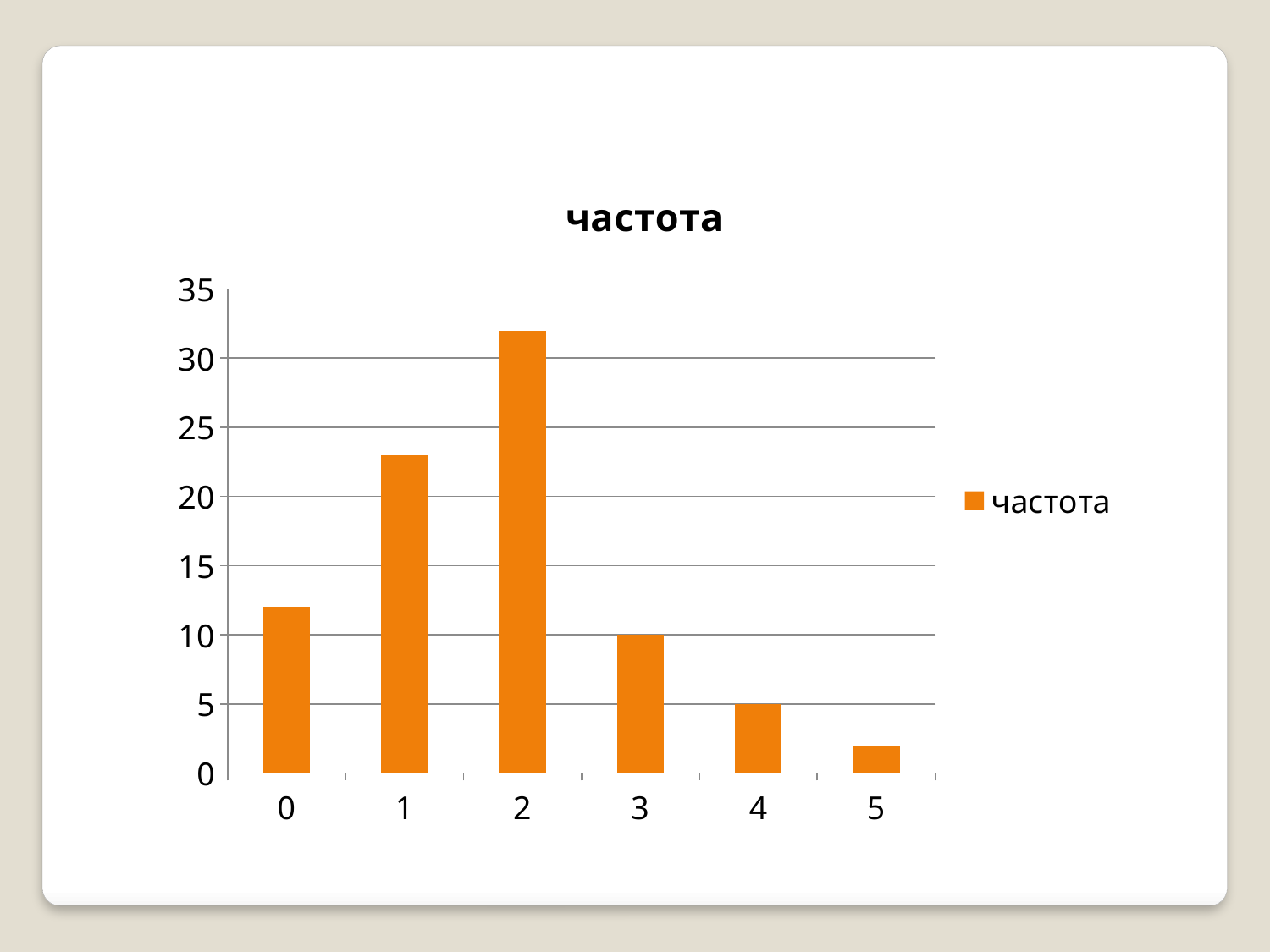
Is the value for category 1 greater or less than 25? less How many series does the legend list? 1 Is the value for category 2 greater or less than 30? greater What is the value for category 4? 5 Which is larger, the value for category 0 or the value for category 3? category 0 What is the value for category 3? 10 What kind of chart is shown on the slide? bar chart Which category has the lowest value? 5 Do the values rise or fall from category 2 to category 5? fall What is the title of the chart? частота How many categories are shown on the x axis? 6 Which category has the highest value? 2